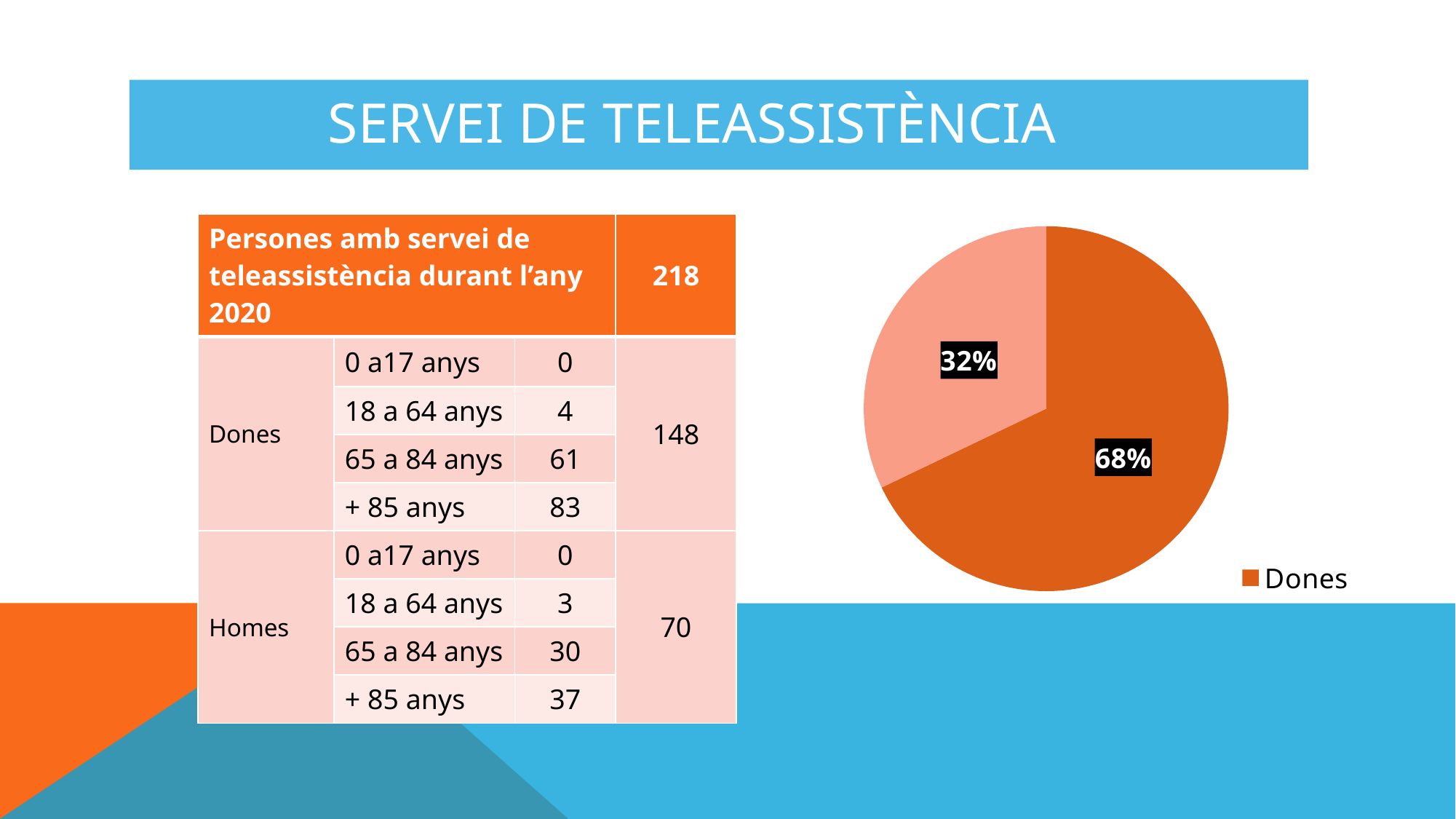
What is the difference in percentage points between the two slices of the pie chart? 36 Which is larger in the pie chart: the Dones slice or the lighter slice? Dones What colour is the Dones slice in the pie chart? dark orange What share of the pie chart does the Dones slice represent? 68% What is the total of the two percentages shown on the pie chart? 100% What percentage is printed on the lighter, smaller slice of the pie chart? 32% Which slice of the pie chart is the largest? Dones How many slices does the pie chart have? 2 Which entry is shown in the legend of the pie chart? Dones What kind of chart is shown on the slide? pie chart